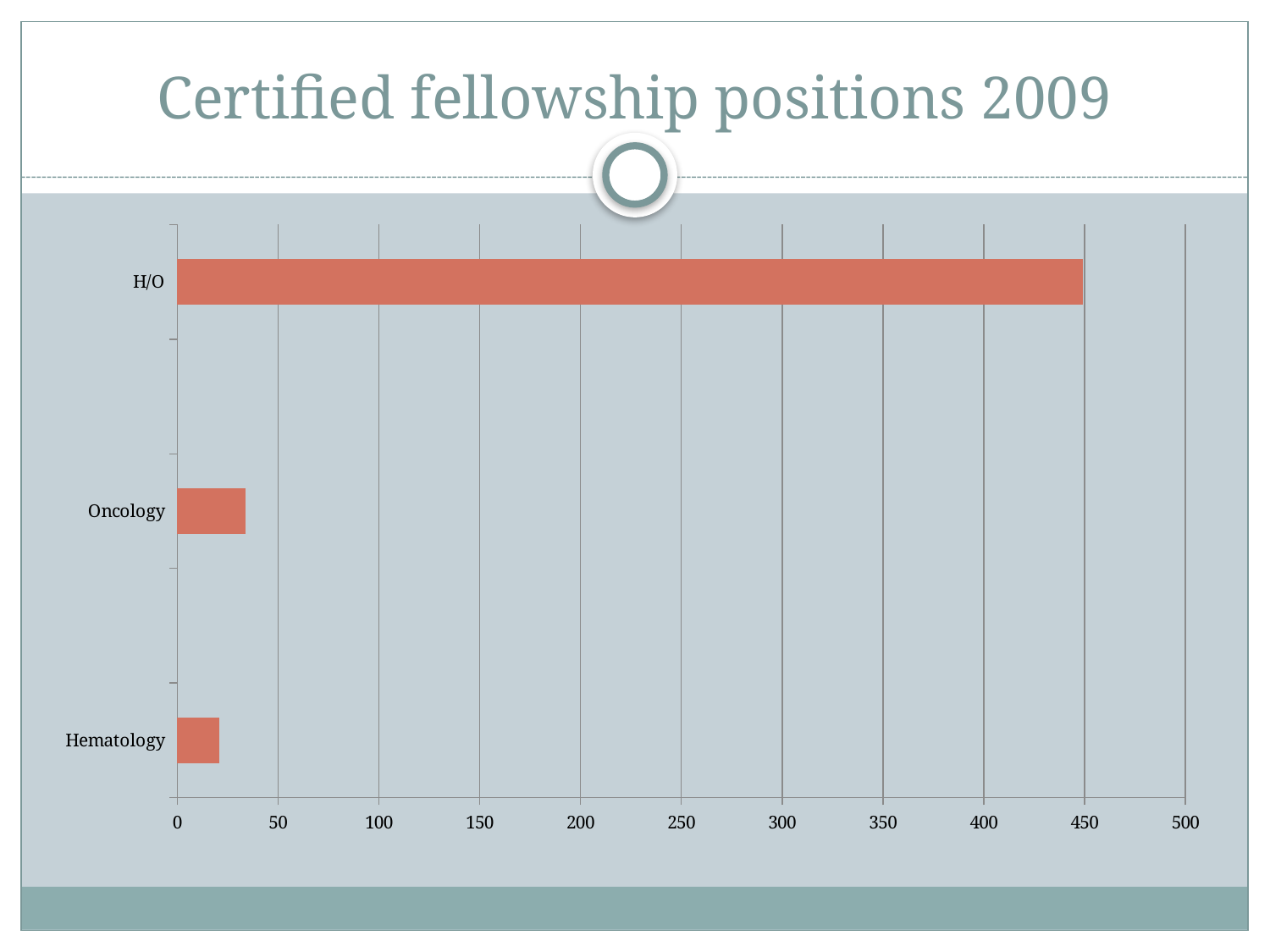
Which category has the lowest value? Hematology What is the maximum value shown on the horizontal axis? 500 What kind of chart is shown on the slide? bar chart Which is larger, the value for Oncology or the value for Hematology? Oncology Is the value for Hematology greater or less than 50? less How many categories are plotted in the chart? 3 Which category has the highest value? H/O Is the value for H/O greater or less than 400? greater What is the title of the slide? Certified fellowship positions 2009 Is the value for Oncology greater or less than 50? less